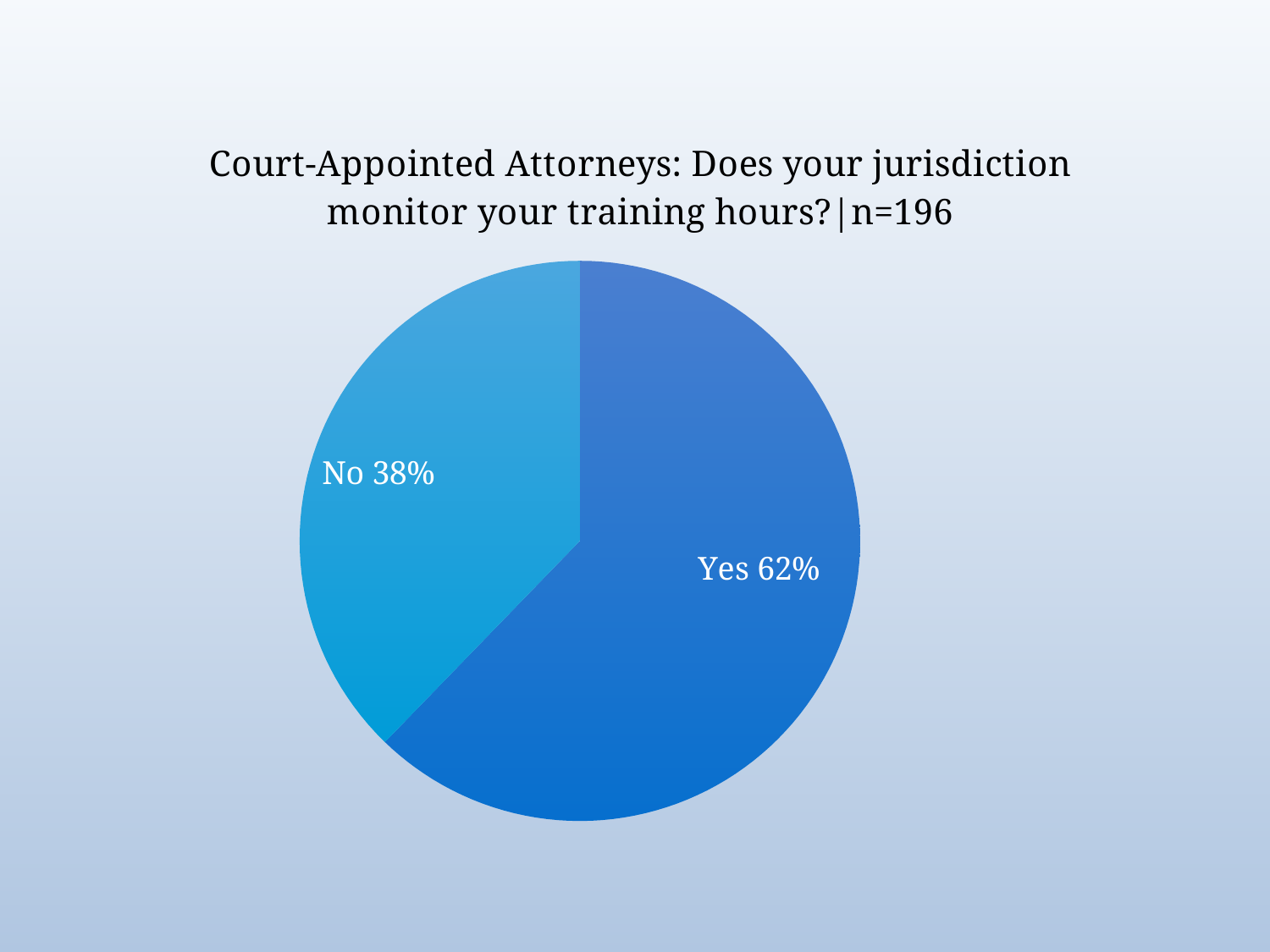
What share of the pie does the No slice represent? 38% How many slices does the pie chart have? 2 What question does the chart title say was asked of court-appointed attorneys? Does your jurisdiction monitor your training hours? What percentage of court-appointed attorneys answered Yes? 62% What percentage of court-appointed attorneys answered No? 38% Which is larger, the Yes share or the No share? Yes What kind of chart is shown on the slide? pie chart What is the sample size (n) given in the chart title? 196 How many percentage points larger is the Yes share than the No share? 24 Which response has the smallest share of the pie? No Which response has the largest share of the pie? Yes